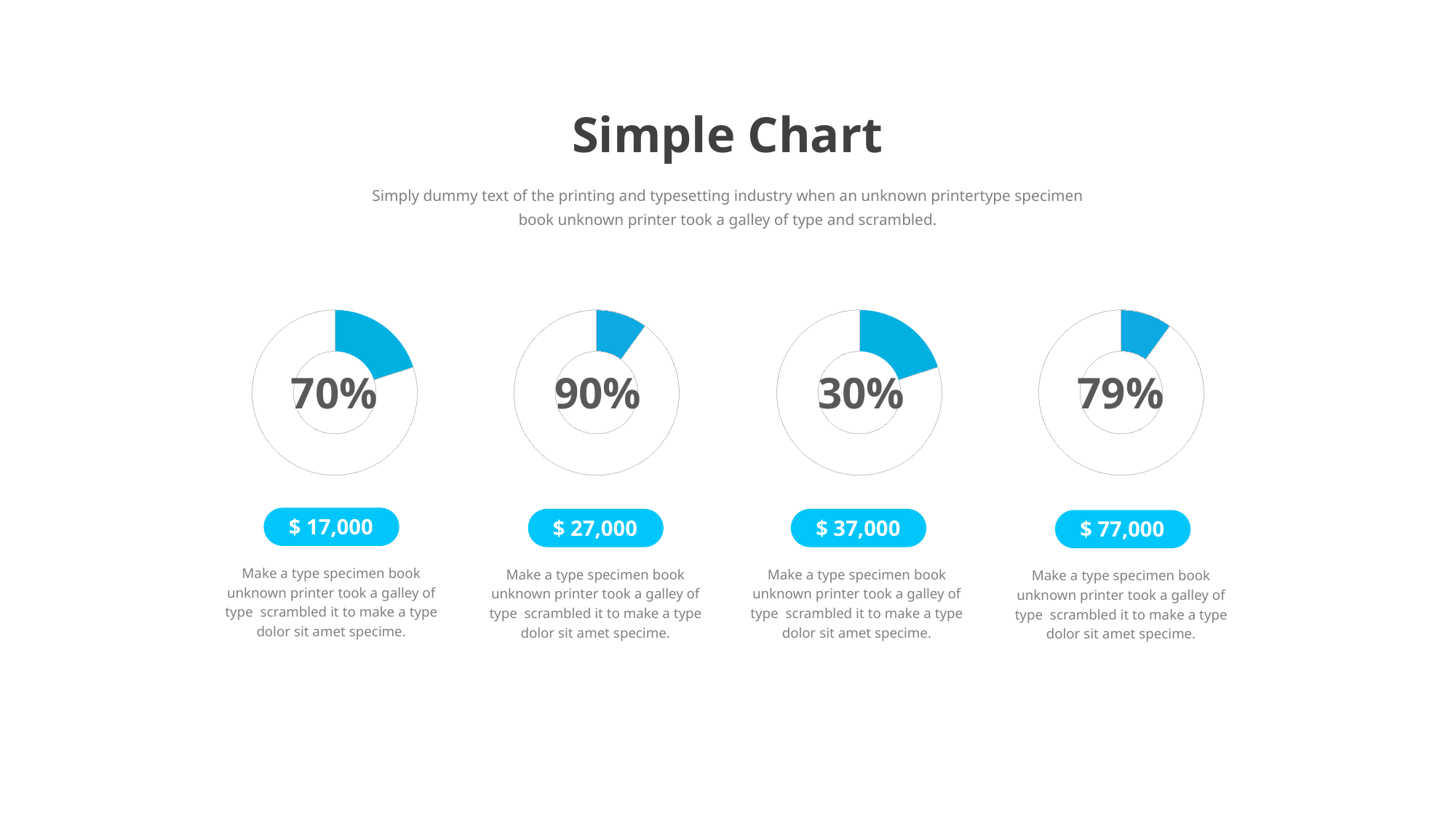
What percentage is shown in the centre of the leftmost donut chart? 70% Which donut chart shows the highest percentage, identified by its dollar label? $ 27,000 What percentage is shown in the centre of the third donut chart from the left? 30% What is the difference between the percentages shown in the second and third donut charts from the left? 60% What percentage is shown in the centre of the rightmost donut chart? 79% Which is larger, the percentage in the leftmost donut chart or the percentage in the rightmost donut chart? the rightmost (79%) Which donut chart shows the lowest percentage, identified by its dollar label? $ 37,000 How many donut charts are on the slide? 4 What is the title of the slide containing the donut charts? Simple Chart What percentage is shown in the centre of the second donut chart from the left? 90% What dollar amount is labelled below the donut chart showing 79%? $ 77,000 What dollar amount is labelled below the donut chart showing 30%? $ 37,000